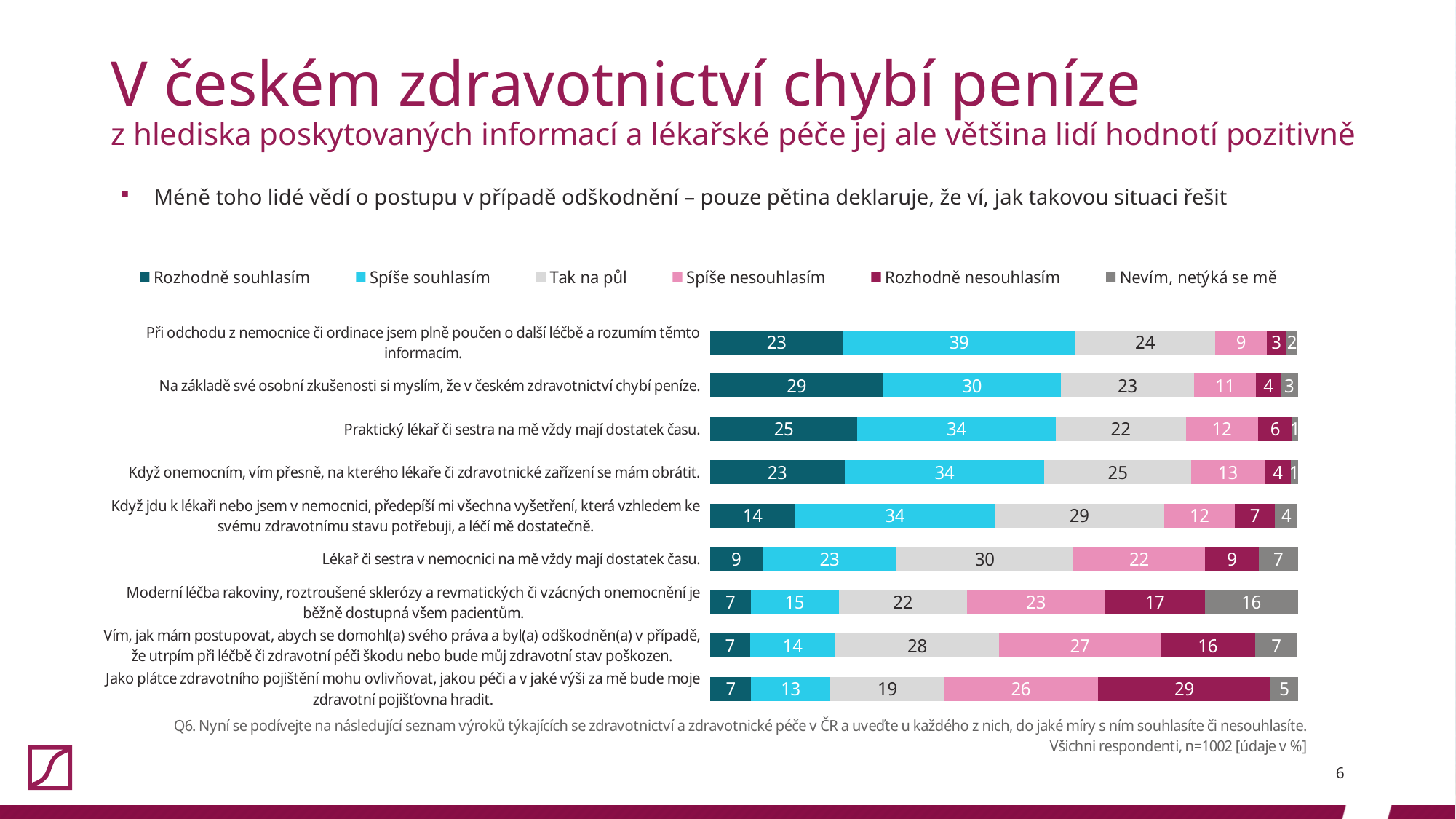
Which statement has the highest 'Rozhodně souhlasím' value? Na základě své osobní zkušenosti si myslím, že v českém zdravotnictví chybí peníze. Which statement has the lowest 'Spíše souhlasím' value? Jako plátce zdravotního pojištění mohu ovlivňovat, jakou péči a v jaké výši za mě bude moje zdravotní pojišťovna hradit. What is the 'Rozhodně souhlasím' value for the statement 'Na základě své osobní zkušenosti si myslím, že v českém zdravotnictví chybí peníze.'? 29 What is the combined 'Rozhodně souhlasím' and 'Spíše souhlasím' value for the statement 'Praktický lékař či sestra na mě vždy mají dostatek času.'? 59 What is the 'Rozhodně nesouhlasím' value for the statement 'Jako plátce zdravotního pojištění mohu ovlivňovat, jakou péči a v jaké výši za mě bude moje zdravotní pojišťovna hradit.'? 29 Which statement has the highest 'Nevím, netýká se mě' value? Moderní léčba rakoviny, roztroušené sklerózy a revmatických či vzácných onemocnění je běžně dostupná všem pacientům. Which is larger: the 'Spíše nesouhlasím' value for 'Vím, jak mám postupovat, abych se domohl(a) svého práva...' or for 'Moderní léčba rakoviny...'? Vím, jak mám postupovat, abych se domohl(a) svého práva... What is the 'Spíše souhlasím' value for the statement 'Při odchodu z nemocnice či ordinace jsem plně poučen o další léčbě a rozumím těmto informacím.'? 39 How many statements (categories) are plotted in the chart? 9 What is the difference between the 'Tak na půl' values for 'Lékař či sestra v nemocnici na mě vždy mají dostatek času.' and 'Praktický lékař či sestra na mě vždy mají dostatek času.'? 8 What type of chart is shown on the slide? Stacked bar chart How many series does the legend list? 6